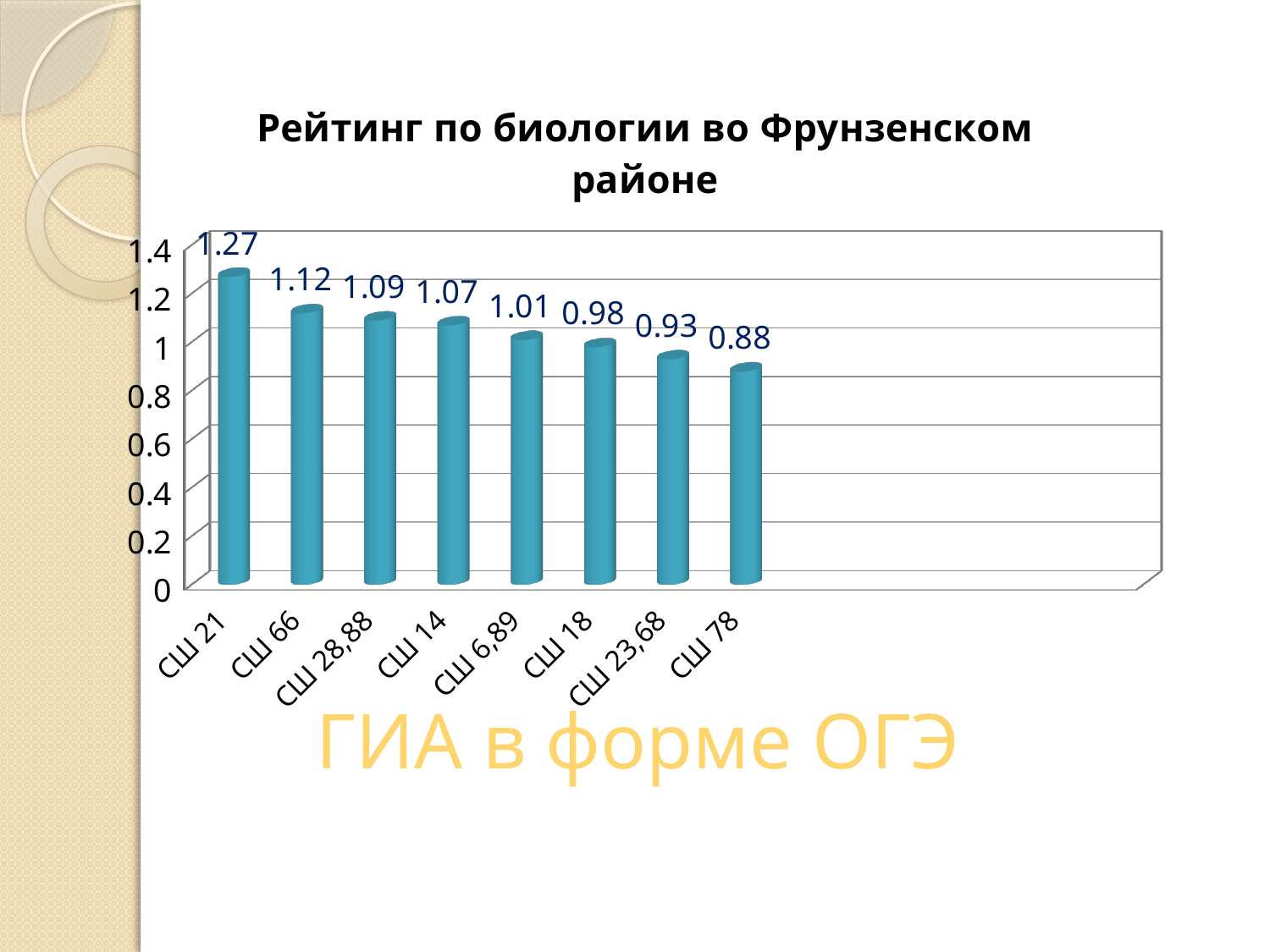
Which has a larger value, СШ 14 or СШ 23,68? СШ 14 What is the value for СШ 78? 0.88 Which school has the highest value? СШ 21 What is the value for СШ 6,89? 1.01 What is the value for СШ 21? 1.27 Is the value for СШ 28,88 greater or less than 1? greater What kind of chart is this? bar chart What is the difference between the values for СШ 66 and СШ 18? 0.14 What is the difference between the values for СШ 21 and СШ 78? 0.39 How many schools are shown on the chart? 8 Do the values rise or fall from left to right along the x axis? fall Which school has the lowest value? СШ 78